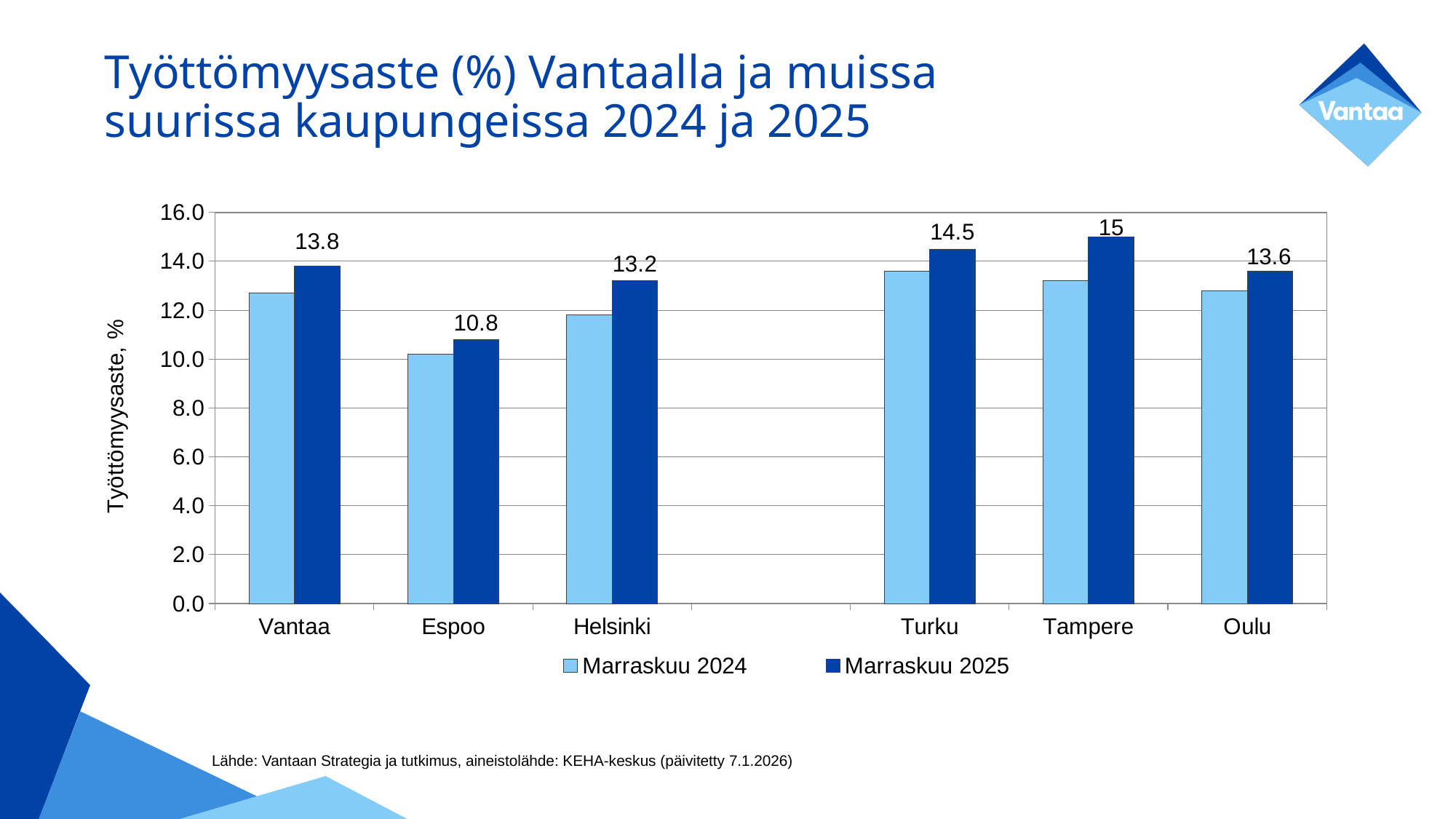
What is the difference between the Marraskuu 2025 values for Tampere and Espoo? 4.2 What is the Marraskuu 2025 value for Turku? 14.5 How many series does the legend list? 2 Which is larger in Marraskuu 2025: Turku or Oulu? Turku What kind of chart is shown on the slide? bar chart What is the Marraskuu 2025 value for Espoo? 10.8 Which city has the lowest Marraskuu 2025 unemployment rate? Espoo Which city has the highest Marraskuu 2025 unemployment rate? Tampere Is the Marraskuu 2024 value for Espoo greater or less than 12.0? less Is the Marraskuu 2024 value for Vantaa greater or less than 12.0? greater How many cities are shown on the x axis? 6 What is the unemployment rate for Vantaa in Marraskuu 2025? 13.8